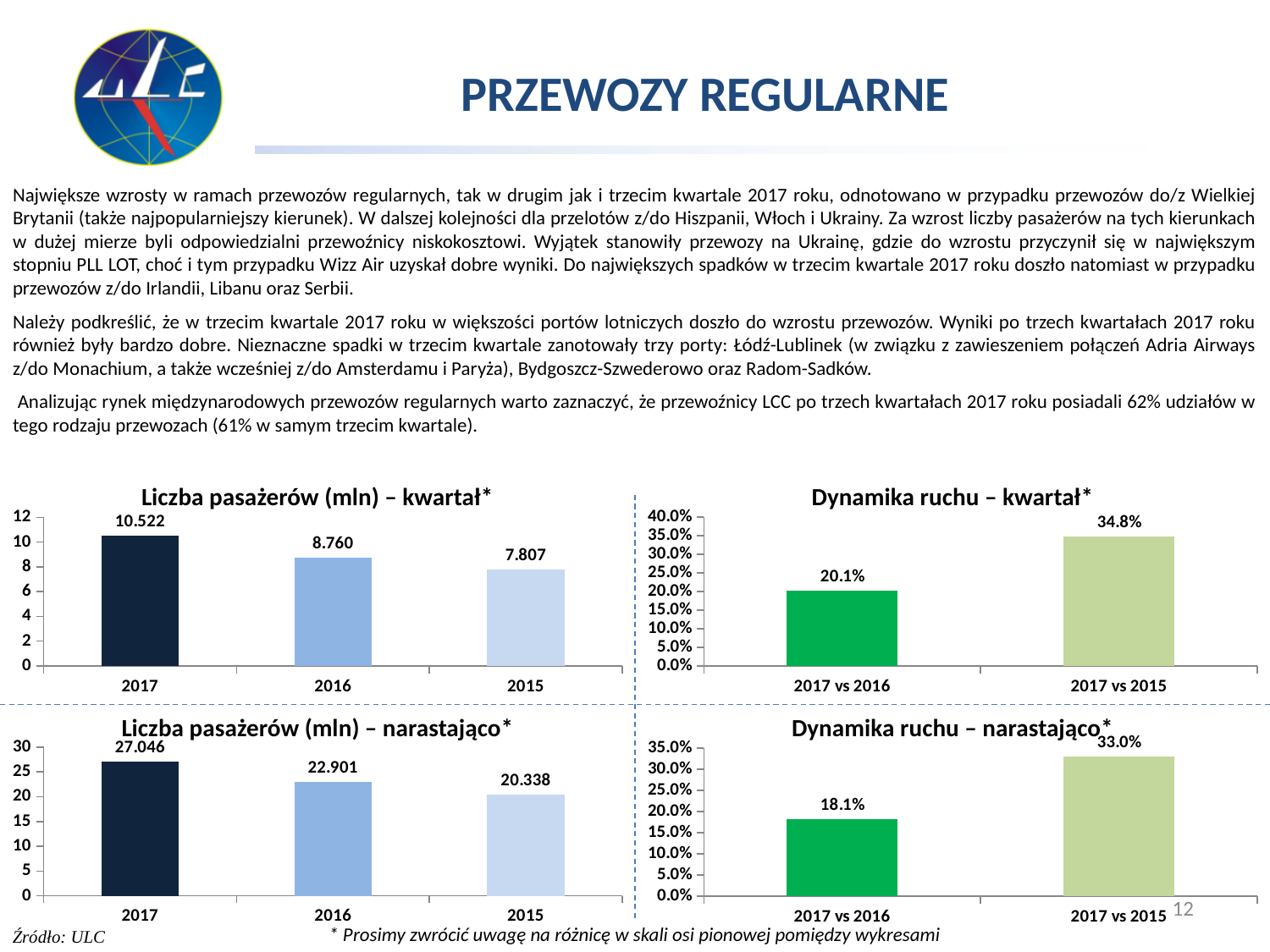
In the chart titled "Liczba pasażerów (mln) – narastająco*", which year has the highest value? 2017 In the chart titled "Dynamika ruchu – kwartał*", how many bars are plotted? 2 In the chart titled "Liczba pasażerów (mln) – narastająco*", what is the value for 2016? 22.901 In the chart titled "Dynamika ruchu – kwartał*", what is the difference between the values for 2017 vs 2015 and 2017 vs 2016? 14.7% In the chart titled "Liczba pasażerów (mln) – kwartał*", what is the value for 2017? 10.522 In the chart titled "Liczba pasażerów (mln) – narastająco*", do the values rise or fall moving from 2017 to 2015 along the x axis? fall In the chart titled "Dynamika ruchu – narastająco*", which is larger, 2017 vs 2016 or 2017 vs 2015? 2017 vs 2015 In the chart titled "Liczba pasażerów (mln) – kwartał*", which year has the lowest value? 2015 What type of chart is the one titled "Dynamika ruchu – narastająco*"? bar chart In the chart titled "Dynamika ruchu – narastająco*", what is the value for 2017 vs 2016? 18.1% In the chart titled "Dynamika ruchu – kwartał*", what is the value for 2017 vs 2015? 34.8% In the chart titled "Liczba pasażerów (mln) – kwartał*", what is the difference between the values for 2017 and 2016? 1.762